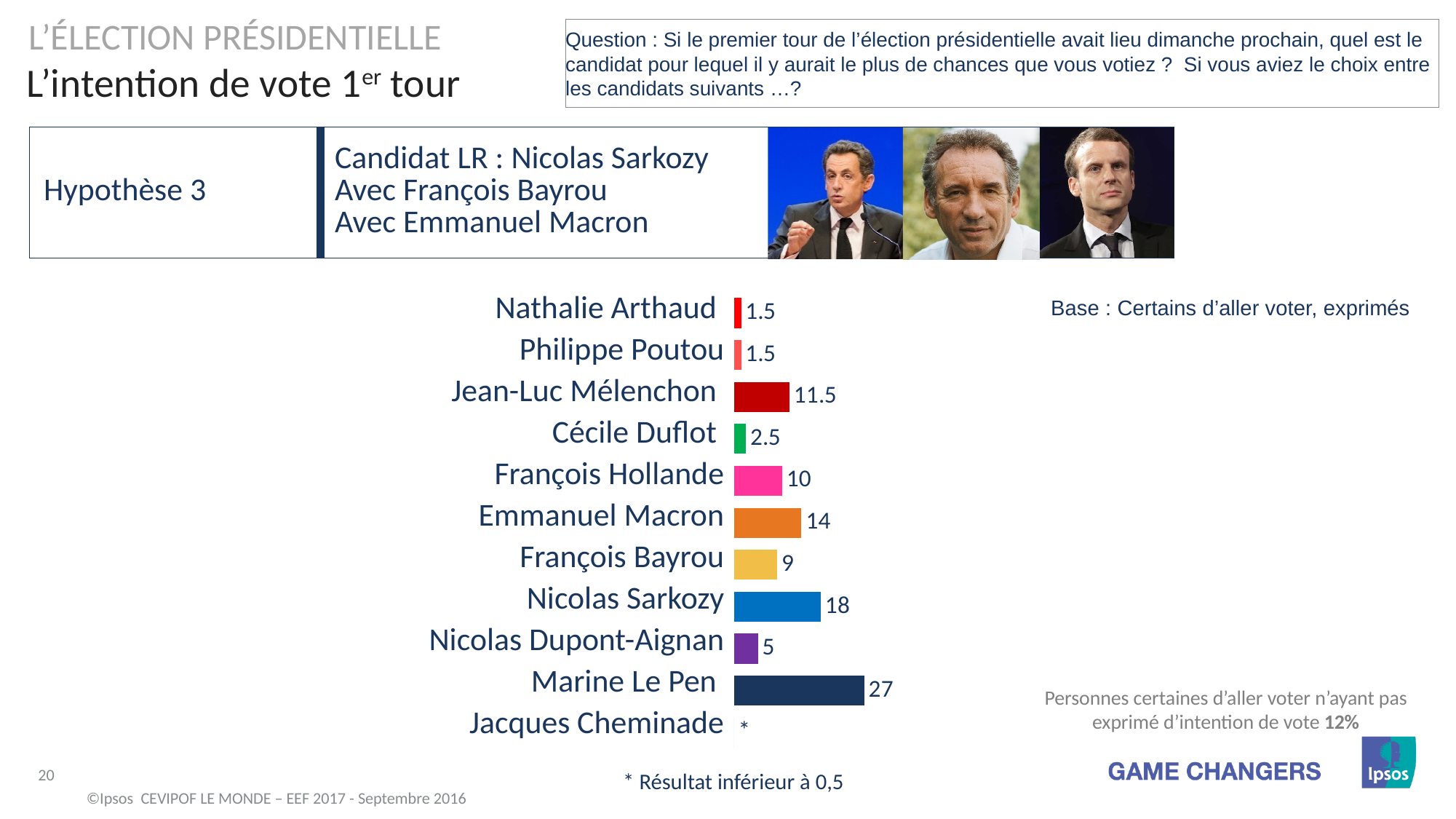
What is the value for Nicolas Dupont-Aignan? 5 Which is larger, the value for Emmanuel Macron or the value for François Hollande? Emmanuel Macron What is the value for Emmanuel Macron? 14 How many candidates are listed in the chart? 11 What is the difference between the values for Marine Le Pen and Nicolas Sarkozy? 9 What is the difference between the values for Jean-Luc Mélenchon and François Hollande? 1.5 Which candidate has the highest value? Marine Le Pen What is the value for Nicolas Sarkozy? 18 What is the value for François Bayrou? 9 What does the asterisk next to Jacques Cheminade mean, according to the note below the chart? Résultat inférieur à 0,5 What is the value for Marine Le Pen? 27 What kind of chart is shown on the slide? Bar chart